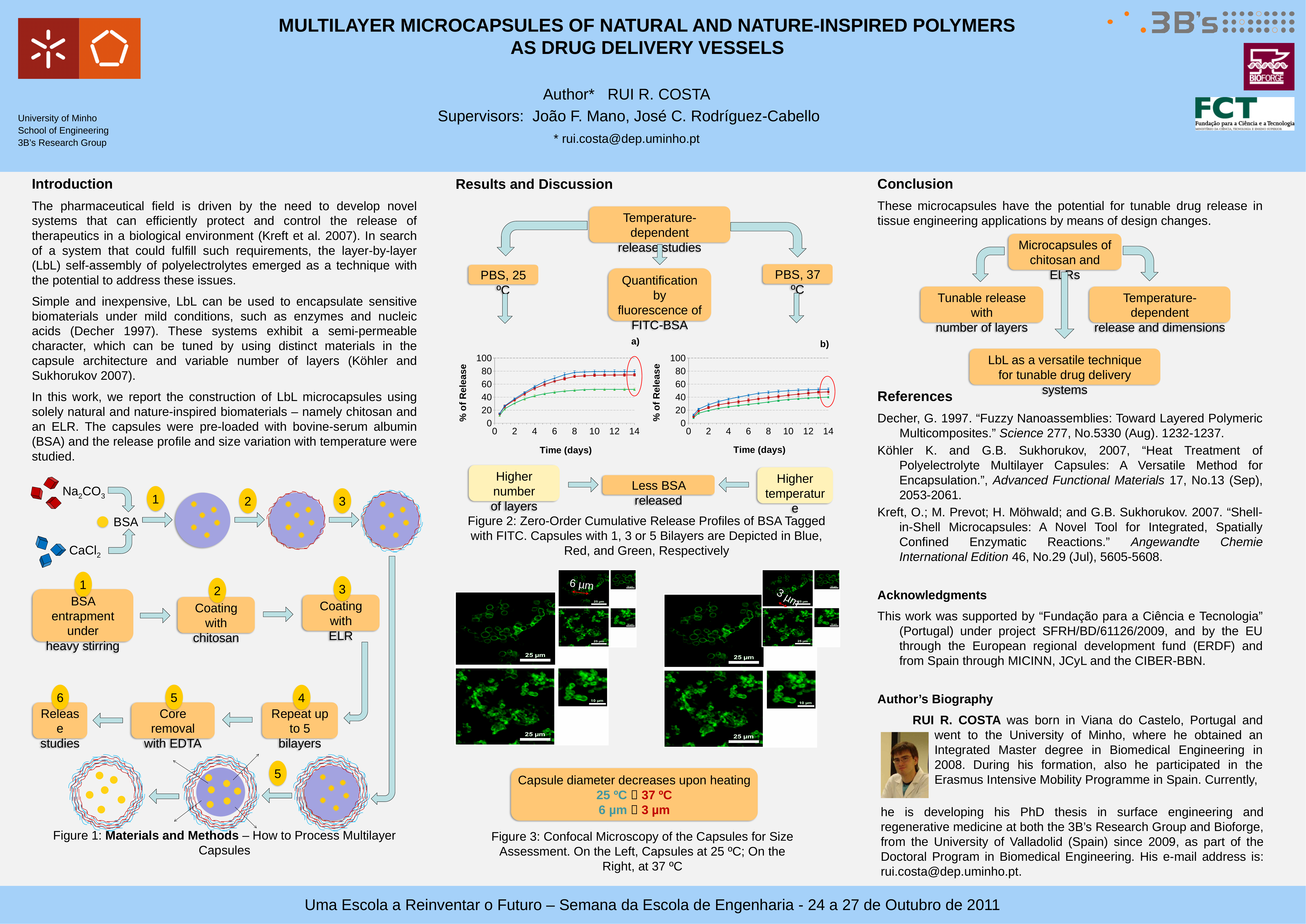
How many series are plotted in chart b) (PBS, 37 ºC)? 3 In chart a) (PBS, 25 ºC), which is larger at 14 days, the blue series or the green series? blue What is the y-axis label of chart a) (PBS, 25 ºC)? % of Release In chart a) (PBS, 25 ºC), do the values rise or fall as time increases along the x axis? rise In chart a) (PBS, 25 ºC), is the value of the green series at 14 days greater or less than 60? less In chart b) (PBS, 37 ºC), do the values rise or fall as time increases along the x axis? rise In chart b) (PBS, 37 ºC), is the value of the green series at 14 days greater or less than 60? less In chart a) (PBS, 25 ºC), which series has the lowest value at 14 days? green What type of chart is chart a) (PBS, 25 ºC)? line chart In chart b) (PBS, 37 ºC), is the value of the blue series at 14 days greater or less than 60? less